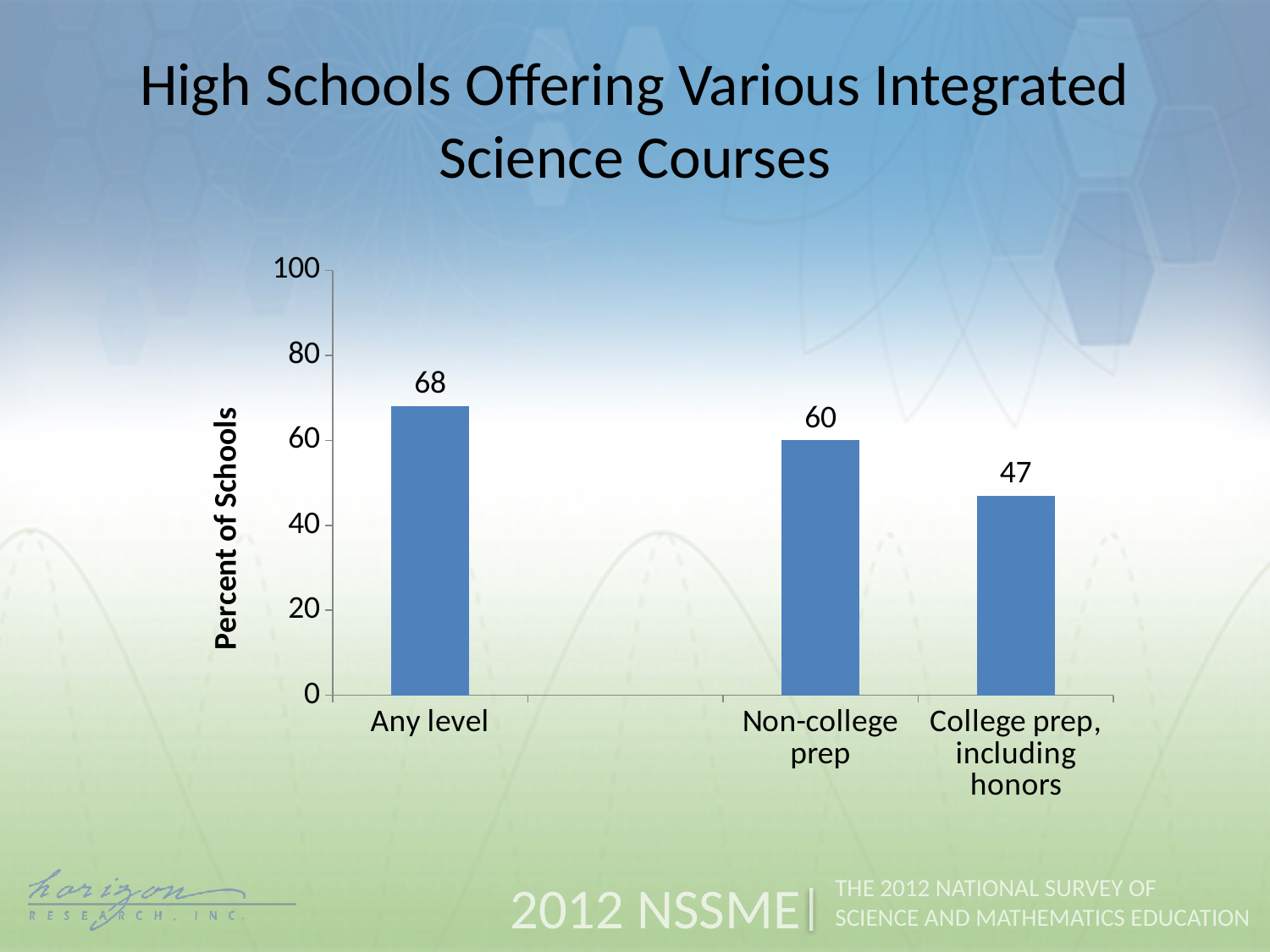
Which category has the highest value? Any level What is the value for College prep, including honors? 47 What is the difference between the values for Any level and Non-college prep? 8 Is the value for College prep, including honors greater or less than 60? less What is the value for Non-college prep? 60 Which category has the lowest value? College prep, including honors What kind of chart is shown on the slide? bar chart Which is larger, the value for Non-college prep or the value for College prep, including honors? Non-college prep What is the value for Any level? 68 What is the difference between the values for Non-college prep and College prep, including honors? 13 What is the label of the vertical axis? Percent of Schools How many categories are shown in the chart? 3